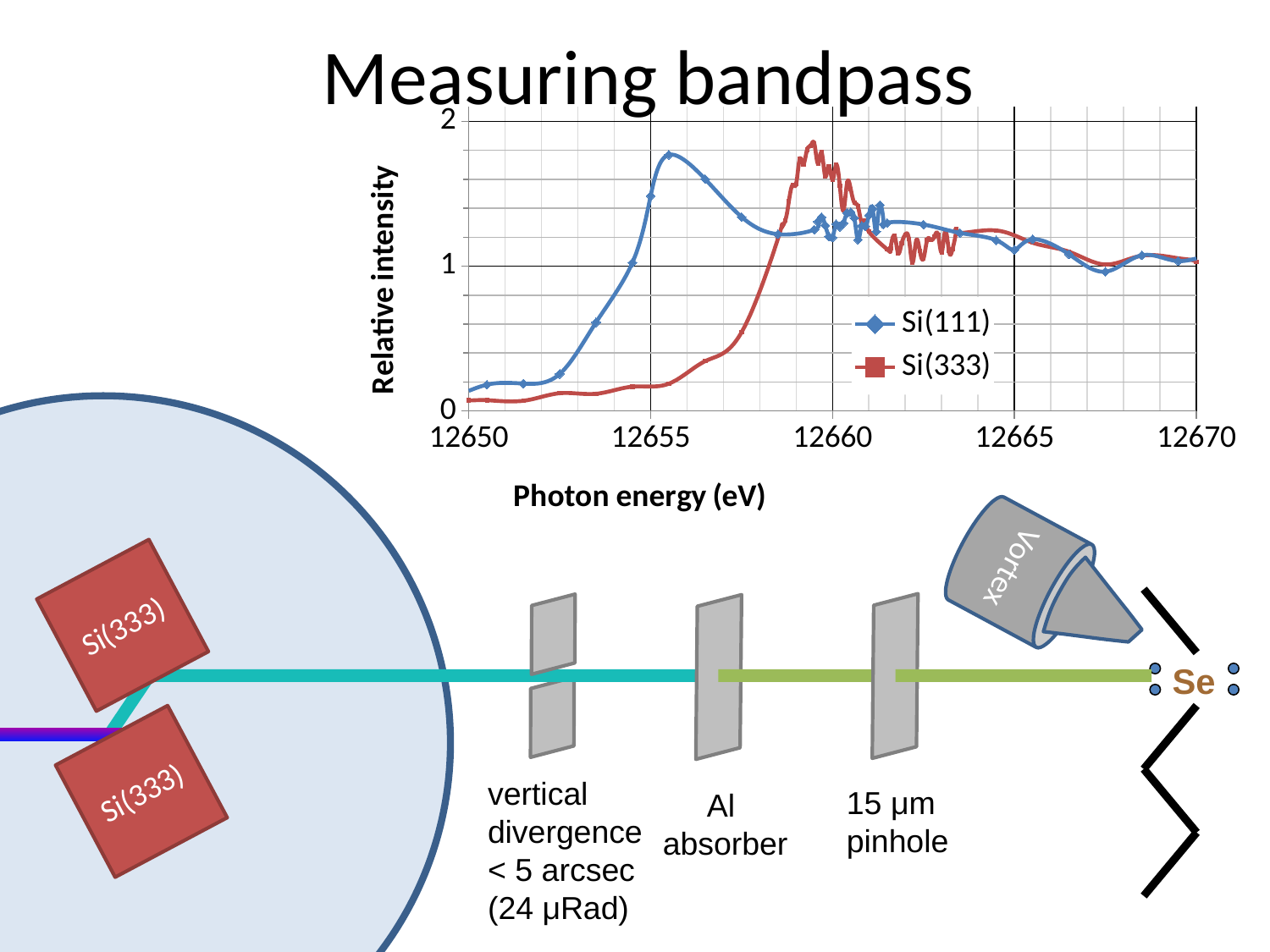
Around 12659.5 eV, which series has the larger relative intensity, Si(111) or Si(333)? Si(333) Is the peak value of the Si(111) series greater or less than 1? greater Is the value of the Si(333) series at 12650 eV greater or less than 1? less Does the Si(111) series rise or fall between 12650 eV and 12655 eV? rise Does the Si(333) series rise or fall between 12657 eV and 12659 eV? rise At 12655 eV, which series has the larger relative intensity, Si(111) or Si(333)? Si(111) What is the label of the chart's x axis? Photon energy (eV) Is the value of the Si(111) series at 12650 eV greater or less than 1? less What are the two series named in the chart legend? Si(111) and Si(333) What kind of chart is shown on the slide? line chart How many series does the chart legend list? 2